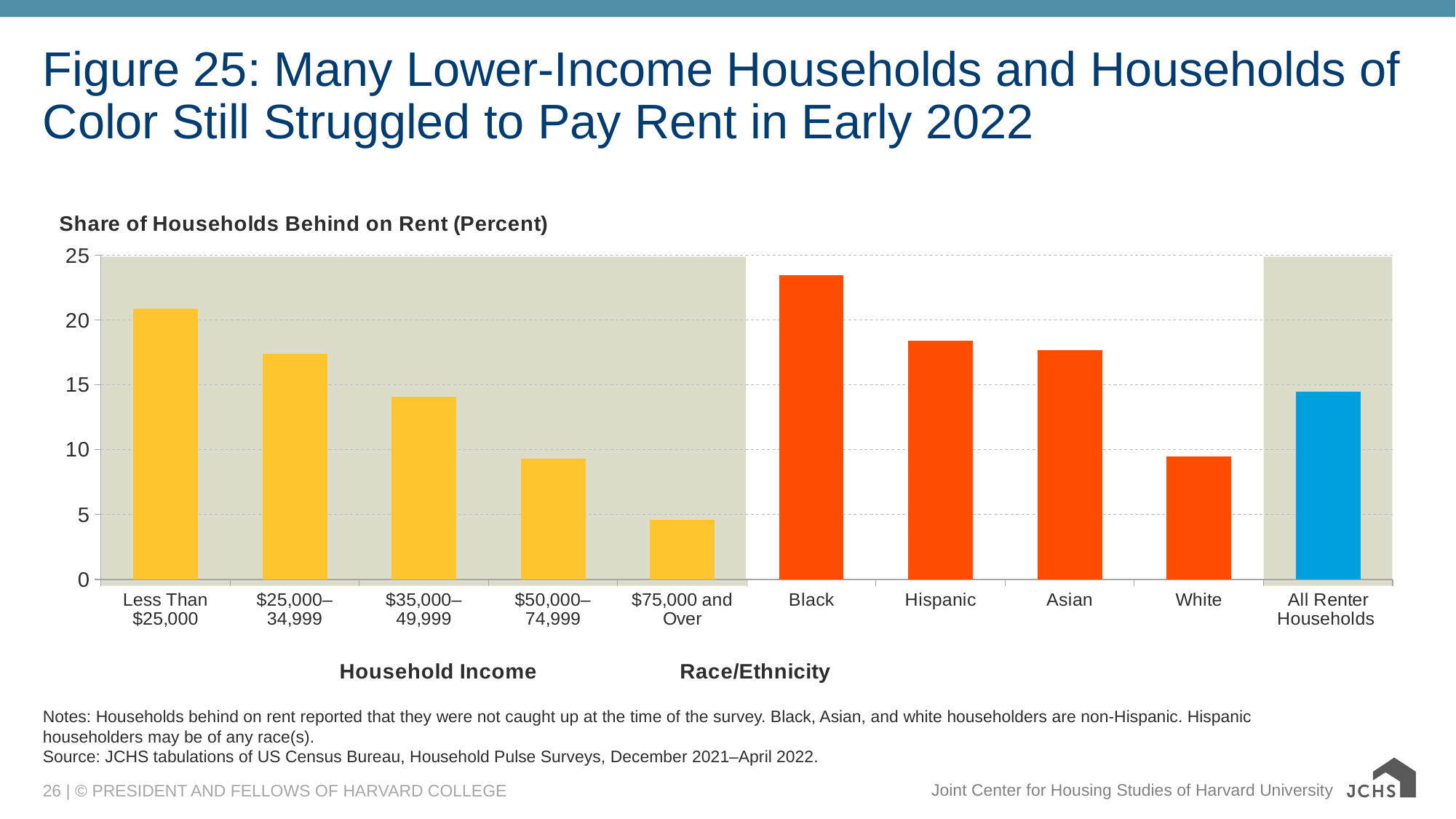
Is the value for Less Than $25,000 greater or less than 20? greater Which is larger, the value for Black or the value for Hispanic? Black What is the axis title shown above the chart? Share of Households Behind on Rent (Percent) What kind of chart is shown on the slide? bar chart Is the value for White greater or less than 10? less Which category has the highest share of households behind on rent? Black Which is larger, the value for All Renter Households or the value for White? All Renter Households Across the Household Income categories from Less Than $25,000 to $75,000 and Over, do the values rise or fall? fall How many categories are plotted on the chart? 10 Is the value for $75,000 and Over greater or less than 5? less Which category has the lowest share of households behind on rent? $75,000 and Over